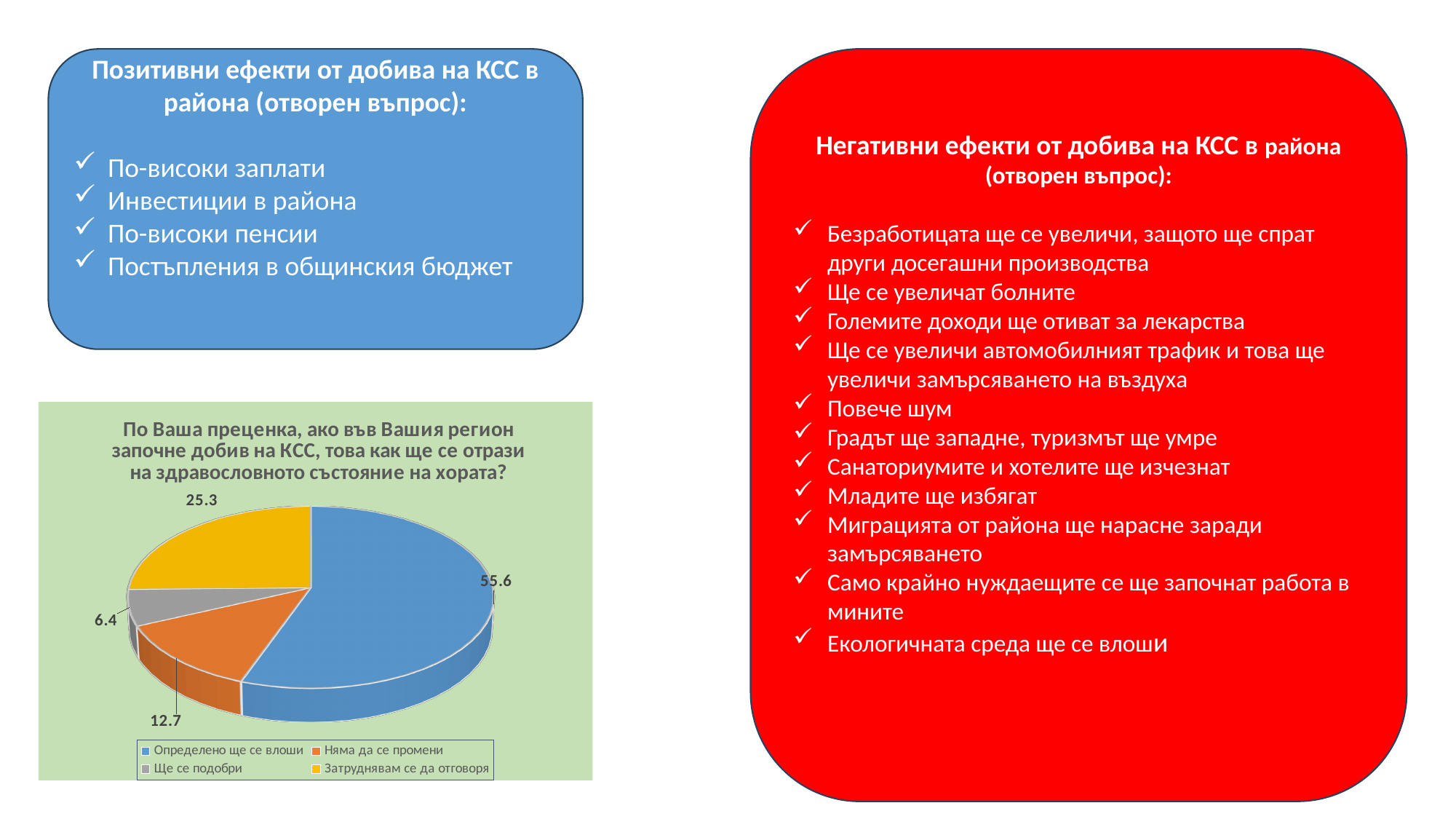
Which colour represents "Затруднявам се да отговоря" in the pie chart? yellow What is the value for "Определено ще се влоши" in the pie chart? 55.6 Which category has the smallest slice in the pie chart? Ще се подобри Which category has the largest slice in the pie chart? Определено ще се влоши What is the value for "Затруднявам се да отговоря" in the pie chart? 25.3 Which is larger: the value for "Няма да се промени" or the value for "Ще се подобри"? Няма да се промени What is the difference between the values for "Определено ще се влоши" and "Затруднявам се да отговоря"? 30.3 What is the value for "Ще се подобри" in the pie chart? 6.4 What is the difference between the values for "Няма да се промени" and "Ще се подобри"? 6.3 What is the value for "Няма да се промени" in the pie chart? 12.7 How many slices does the pie chart have? 4 What kind of chart is shown on the slide? pie chart